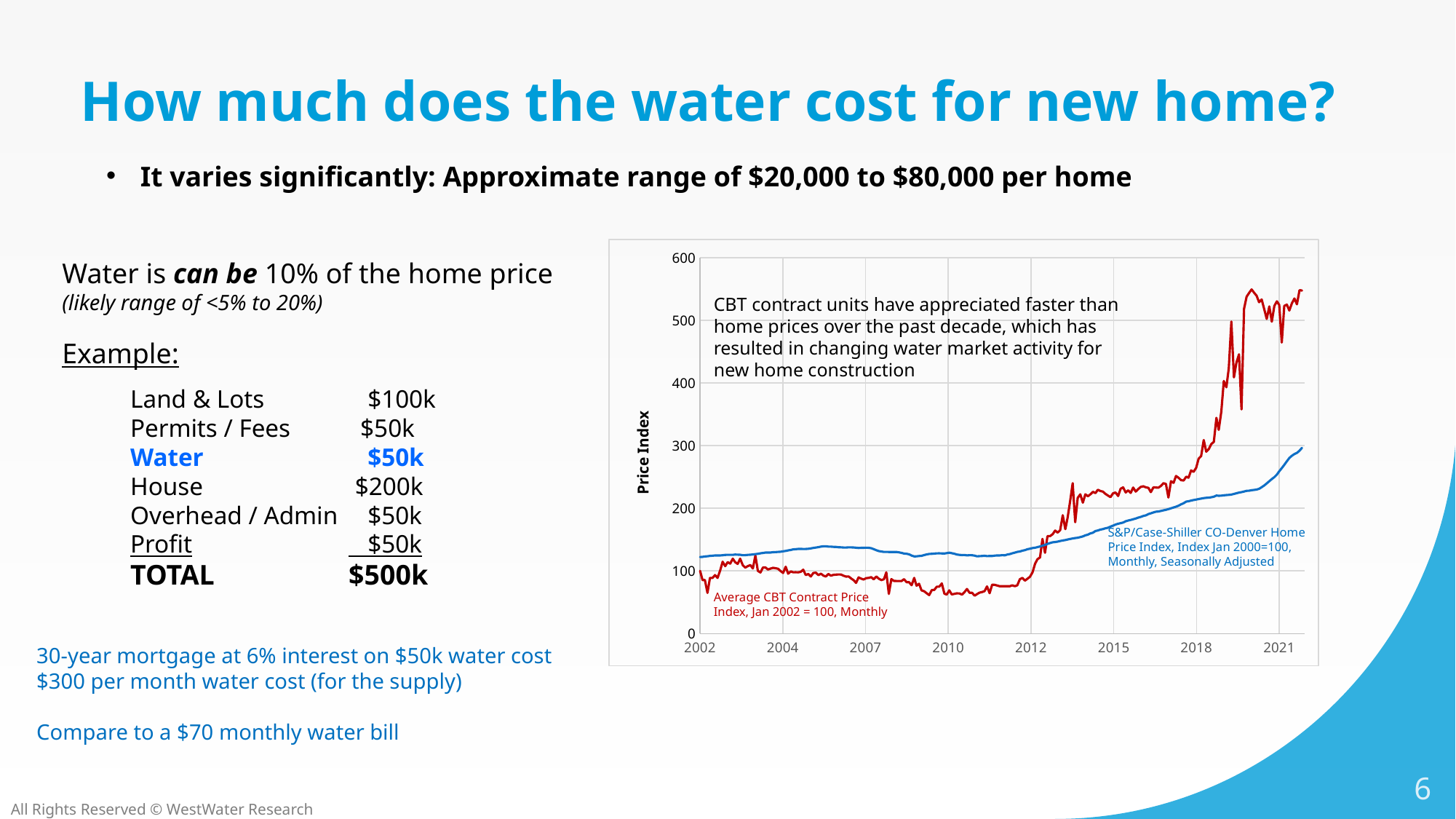
Is the value of the S&P/Case-Shiller CO-Denver Home Price Index in 2021 greater or less than 300? less How many series are plotted on the chart? 2 What is the label on the vertical axis of the chart? Price Index How many year labels are shown on the x axis of the chart? 8 In 2021, which series has the higher value: the Average CBT Contract Price Index or the S&P/Case-Shiller CO-Denver Home Price Index? Average CBT Contract Price Index Is the value of the Average CBT Contract Price Index in 2010 greater or less than 100? less Is the value of the Average CBT Contract Price Index in 2021 greater or less than 400? greater Which colour is used for the Average CBT Contract Price Index line? red What kind of chart is shown on the slide? line chart In 2010, which series has the higher value: the Average CBT Contract Price Index or the S&P/Case-Shiller CO-Denver Home Price Index? S&P/Case-Shiller CO-Denver Home Price Index Does the Average CBT Contract Price Index rise or fall between 2012 and 2021? rise